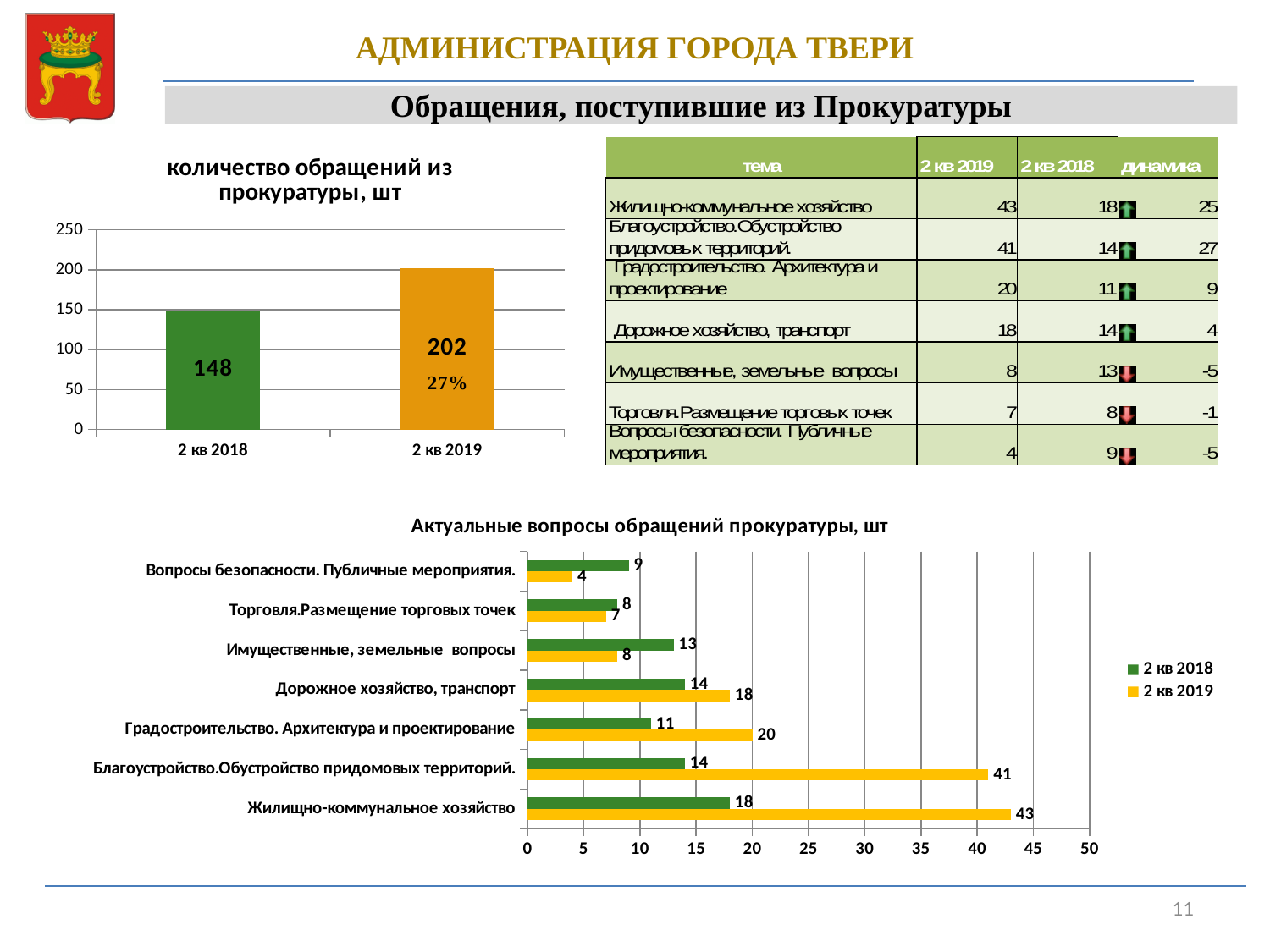
In the chart titled "количество обращений из прокуратуры, шт", what is the value for 2 кв 2018? 148 In the chart titled "Актуальные вопросы обращений прокуратуры, шт", what is the 2 кв 2018 value for Градостроительство. Архитектура и проектирование? 11 In the chart titled "Актуальные вопросы обращений прокуратуры, шт", what is the difference between the 2 кв 2019 and 2 кв 2018 values for Благоустройство.Обустройство придомовых территорий.? 27 In the chart titled "Актуальные вопросы обращений прокуратуры, шт", how many series does the legend list? 2 In the chart titled "Актуальные вопросы обращений прокуратуры, шт", what is the 2 кв 2019 value for Жилищно-коммунальное хозяйство? 43 In the chart titled "количество обращений из прокуратуры, шт", what is the difference between the 2 кв 2019 and 2 кв 2018 values? 54 In the chart titled "Актуальные вопросы обращений прокуратуры, шт", how many categories are shown? 7 What kind of chart is the one titled "Актуальные вопросы обращений прокуратуры, шт"? Bar chart In the chart titled "Актуальные вопросы обращений прокуратуры, шт", which category has the lowest 2 кв 2019 value? Вопросы безопасности. Публичные мероприятия. In the chart titled "Актуальные вопросы обращений прокуратуры, шт", which category has the highest 2 кв 2019 value? Жилищно-коммунальное хозяйство In the chart titled "количество обращений из прокуратуры, шт", which period has the higher value? 2 кв 2019 In the chart titled "количество обращений из прокуратуры, шт", what is the value for 2 кв 2019? 202